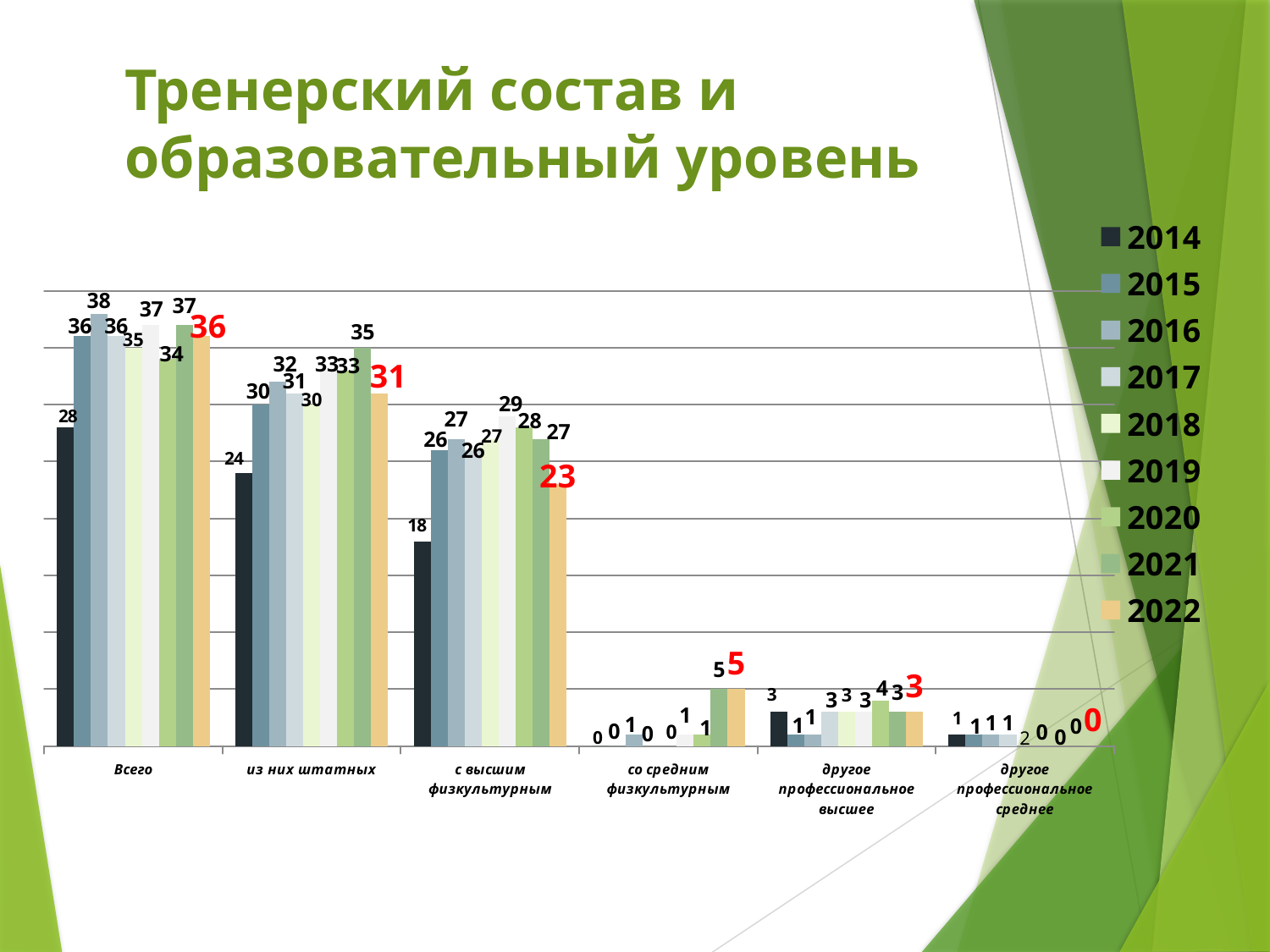
What is the value for 2014 in the category "с высшим физкультурным"? 18 What kind of chart is shown on the slide? bar chart Which year has the lowest value in the category "из них штатных"? 2014 Which year has the highest value in the category "Всего"? 2016 What is the value for 2022 in the category "Всего"? 36 What is the value for 2022 in the category "со средним физкультурным"? 5 In the category "с высшим физкультурным", which is larger: the value for 2019 or the value for 2022? 2019 What is the title of the chart on the slide? Тренерский состав и образовательный уровень How many series does the legend list? 9 What is the value for 2021 in the category "из них штатных"? 35 How many categories are shown on the x axis? 6 What is the difference between the 2016 and 2014 values in the category "Всего"? 10